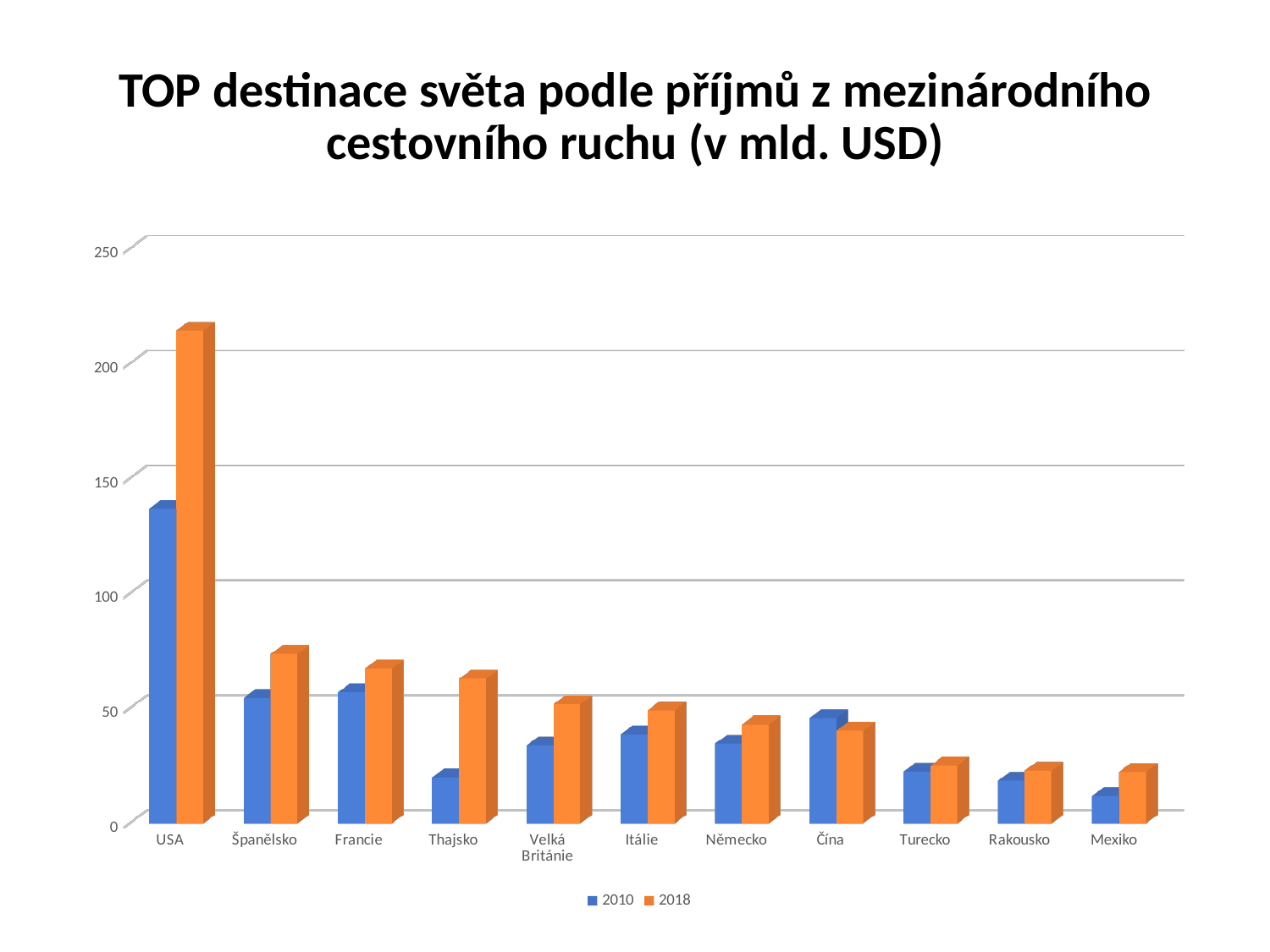
How many series does the legend of the chart list? 2 Is the 2010 value for USA greater or less than 150? less Is the 2010 value for Thajsko greater or less than 50? less How many destinations (categories) are shown on the x axis of the chart? 11 What kind of chart is shown on the slide? bar chart Is the 2018 value for Španělsko greater or less than 50? greater Which destination has the highest value for 2018? USA Which has the larger 2018 value, Thajsko or Velká Británie? Thajsko Which series is shown in orange in the chart? 2018 Which destination has the lowest value for 2010? Mexiko For Čína, which series has the larger value, 2010 or 2018? 2010